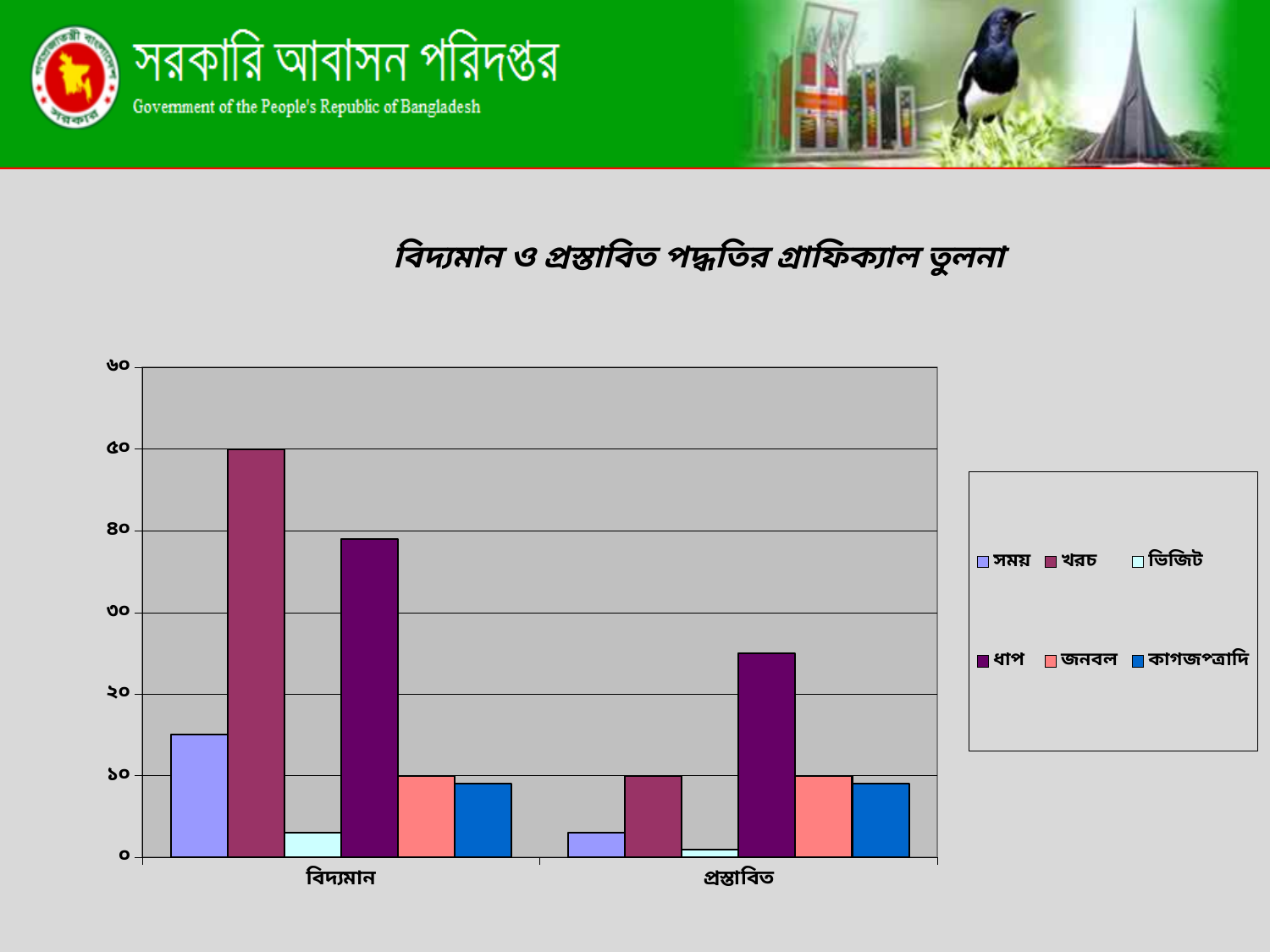
What is the value of খরচ for প্রস্তাবিত? ১০ What is the difference between the খরচ values for বিদ্যমান and প্রস্তাবিত? ৪০ Is the value of ধাপ for বিদ্যমান greater or less than ৩০? greater Which series has the highest value in the প্রস্তাবিত category? ধাপ What kind of chart is shown on the slide? bar chart What is the title of the chart? বিদ্যমান ও প্রস্তাবিত পদ্ধতির গ্রাফিক্যাল তুলনা How many categories are shown on the x axis of the chart? 2 How many series does the chart's legend list? 6 Which series has the lowest value in the প্রস্তাবিত category? ভিজিট Which series has the highest value in the বিদ্যমান category? খরচ Is the value of ধাপ larger for বিদ্যমান or for প্রস্তাবিত? বিদ্যমান What is the value of খরচ for বিদ্যমান? ৫০